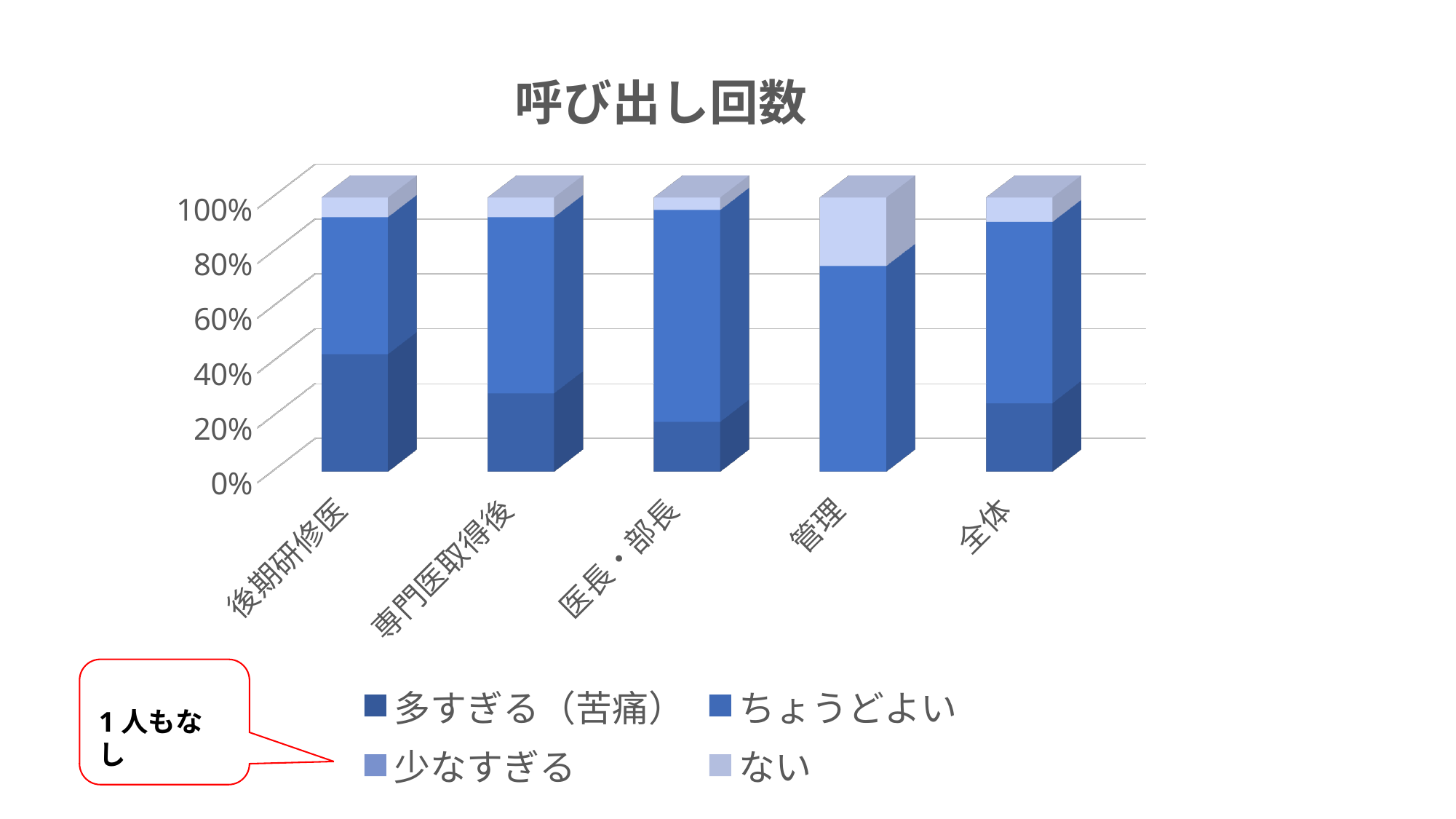
What is the title of the chart? 呼び出し回数 How many series does the legend list? 4 Is the 多すぎる（苦痛） segment for 後期研修医 greater or less than 20%? greater How many categories are shown on the x axis of the chart? 5 Which category has the largest ない segment? 管理 What kind of chart is shown on the slide? stacked bar chart Which category has the largest ちょうどよい segment? 医長・部長 Which series does the callout "1人もなし" point to in the legend? 少なすぎる Is the 多すぎる（苦痛） segment for 医長・部長 greater or less than 40%? less Which is larger, the 多すぎる（苦痛） segment for 後期研修医 or for 専門医取得後? 後期研修医 Which category has the largest 多すぎる（苦痛） segment? 後期研修医 Is the ない segment for 管理 greater or less than 10%? greater